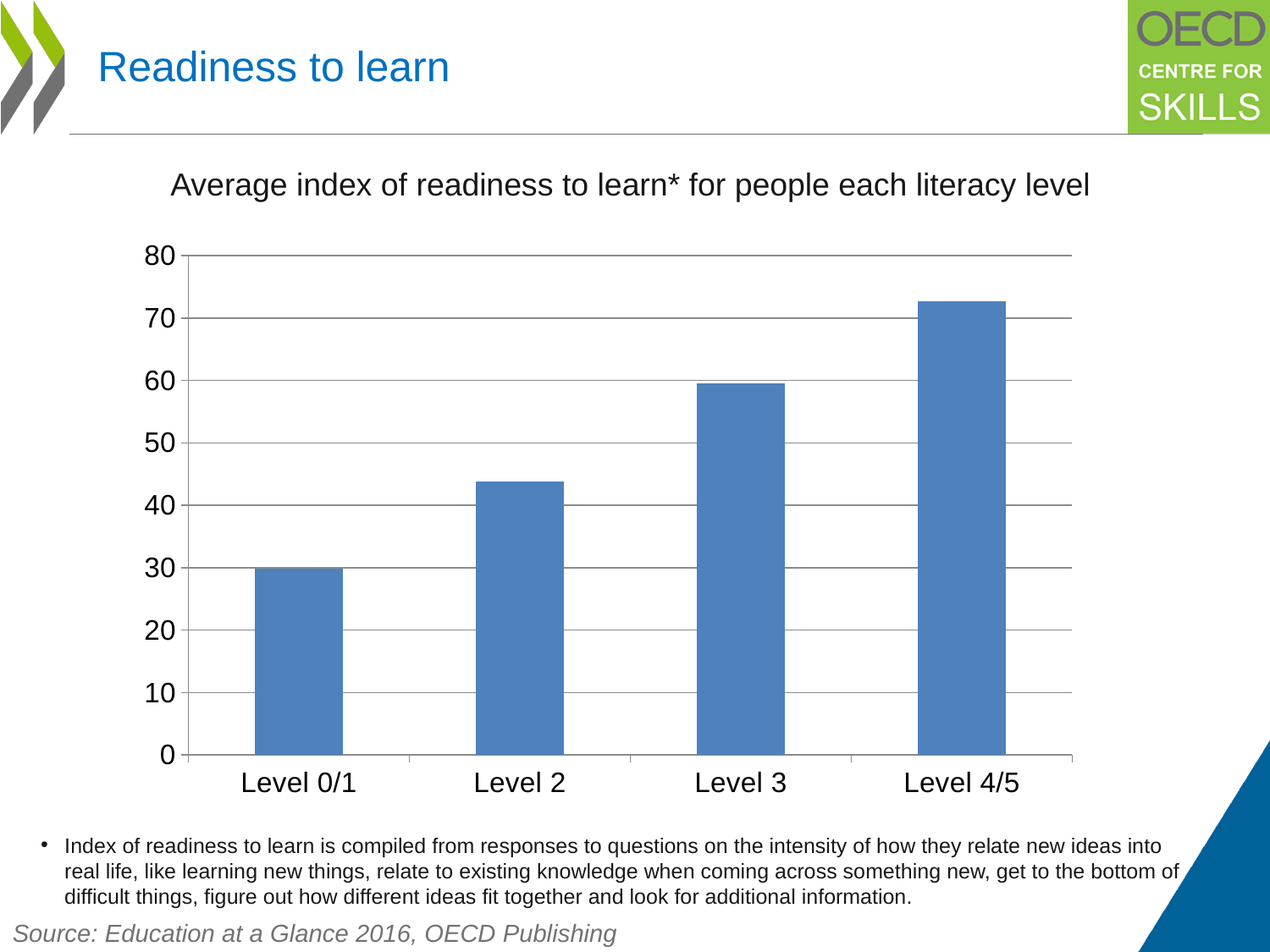
What is the maximum value shown on the vertical axis of the chart? 80 How many literacy levels are shown on the x axis of the chart? 4 Is the value for Level 2 greater or less than 50? less What is the title of the chart? Average index of readiness to learn* for people each literacy level Which has a higher average index of readiness to learn, Level 2 or Level 3? Level 3 Do the values rise or fall as literacy level increases from Level 0/1 to Level 4/5? rise Which literacy level has the highest average index of readiness to learn? Level 4/5 Is the value for Level 3 greater or less than 50? greater Which literacy level has the lowest average index of readiness to learn? Level 0/1 Is the value for Level 4/5 greater or less than 70? greater What kind of chart is shown on the slide? bar chart